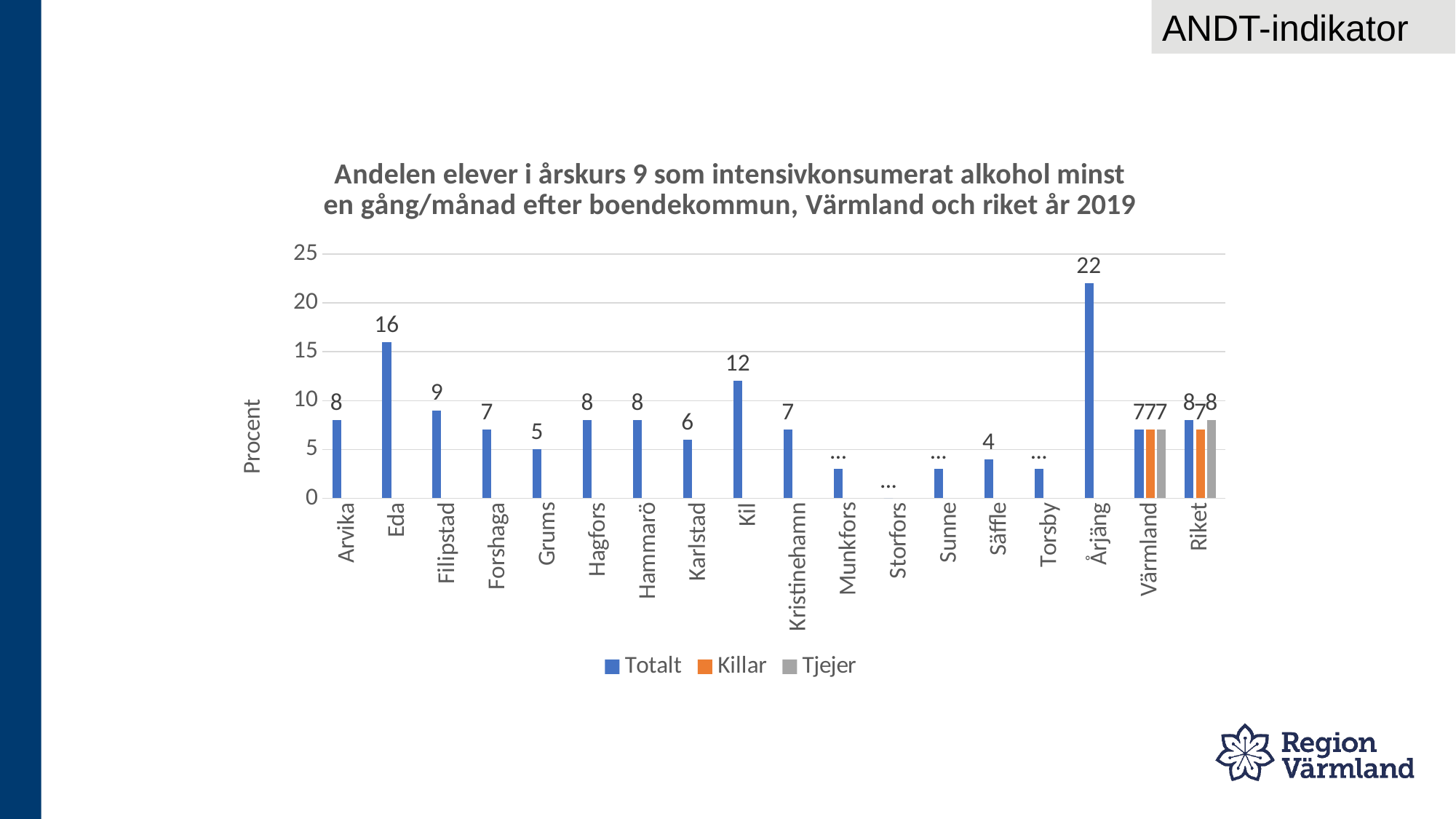
How many series does the legend list? 3 Is the Totalt value for Årjäng greater or less than 20? greater What is the Totalt value for Kil? 12 Which municipality has the highest Totalt value? Årjäng What is the difference between the Totalt values for Årjäng and Eda? 6 What is the Totalt value for Eda? 16 What is the label of the y axis? Procent Among the municipalities with a printed Totalt value, which has the lowest? Säffle How many categories are shown on the x axis? 18 What is the Killar value for Riket? 7 What kind of chart is shown on the slide? Bar chart Which has a larger Totalt value, Kil or Filipstad? Kil